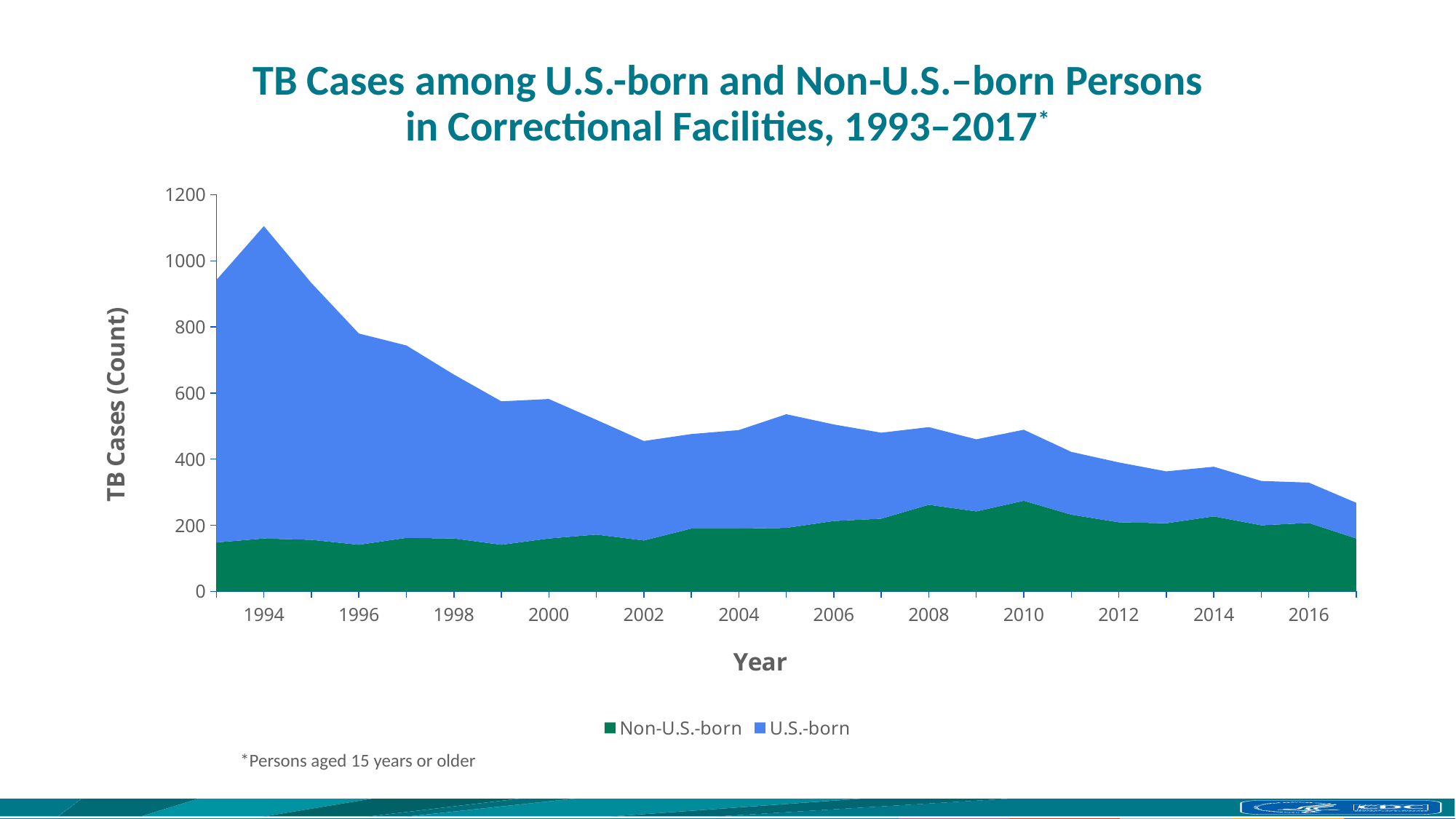
Is the number of TB cases among Non-U.S.-born persons in 1993 greater or less than 200? less Is the total number of TB cases in 2017 greater or less than 400? less In which year is the total number of TB cases in correctional facilities highest? 1994 Is the number of TB cases among Non-U.S.-born persons in 2010 greater or less than 200? greater Which year has more total TB cases, 1994 or 2017? 1994 In which year is the total number of TB cases in correctional facilities lowest? 2017 How many years are plotted along the x axis? 25 Which two series are listed in the legend? Non-U.S.-born and U.S.-born How many series does the legend list? 2 Overall, do total TB cases in correctional facilities rise or fall from 1994 to 2017? fall What kind of chart is shown on the slide? Stacked area chart